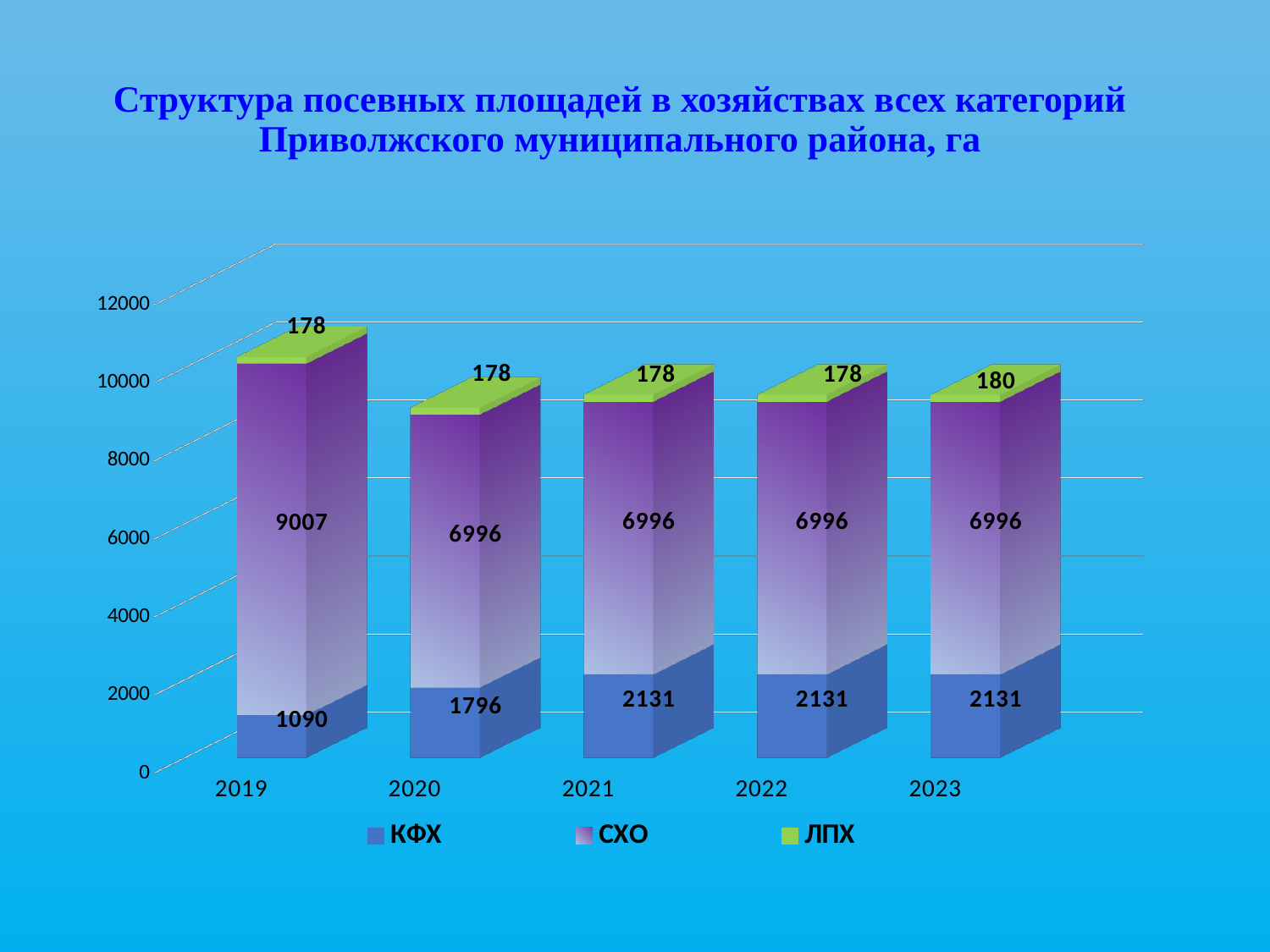
How many years are shown on the x axis? 5 What is the total of the stacked bar for 2019? 10275 What kind of chart is shown on the slide? Stacked bar chart Which is larger, the КФХ value in 2020 or the КФХ value in 2021? 2021 What is the difference between the КФХ value in 2021 and the КФХ value in 2019? 1041 What is the value for СХО in 2020? 6996 What is the value for КФХ in 2019? 1090 What is the total of the stacked bar for 2023? 9307 How many series does the legend list? 3 In which year is the value for КФХ lowest? 2019 What is the value for ЛПХ in 2023? 180 In which year is the value for СХО highest? 2019